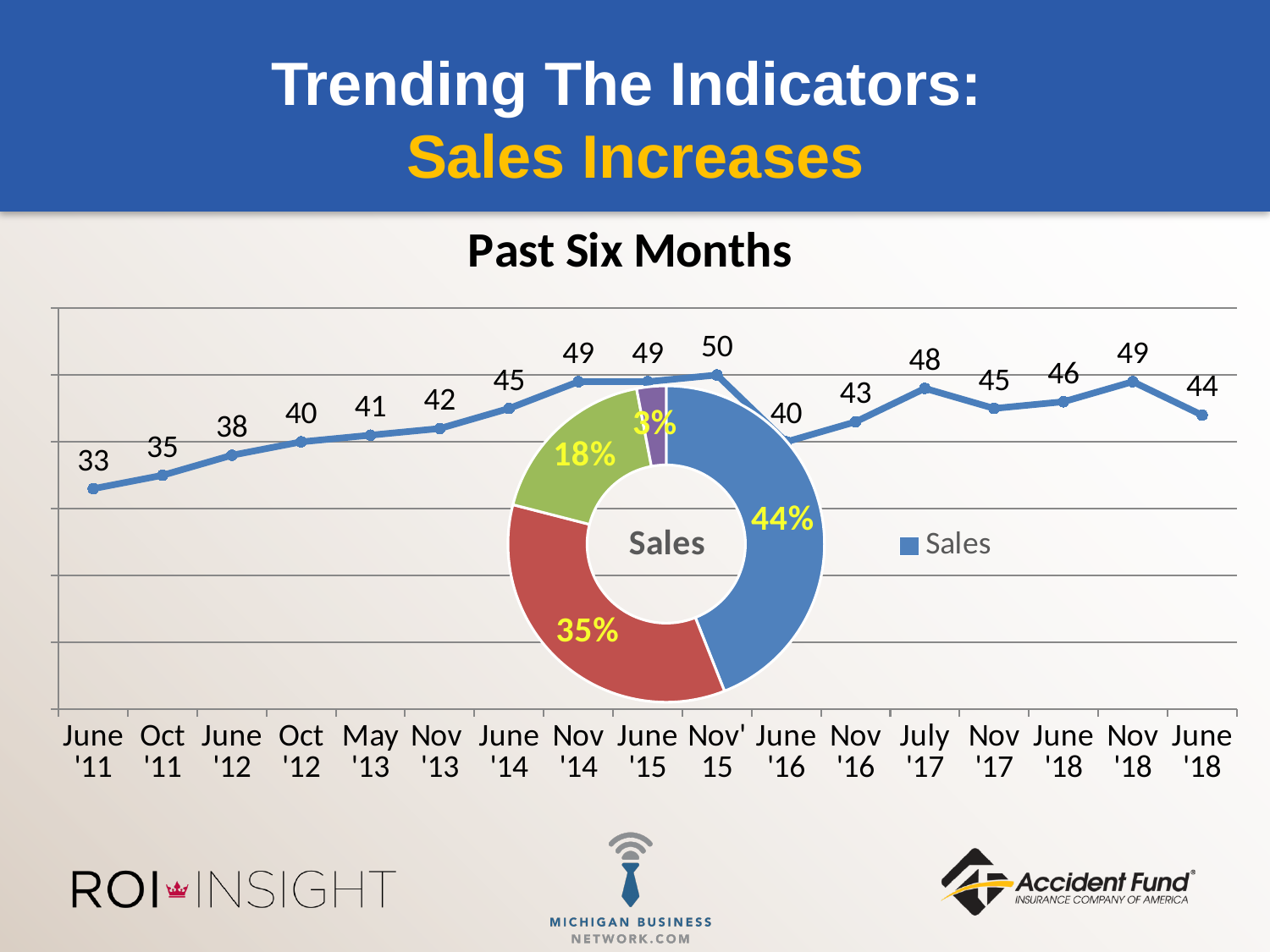
On the line chart, which is larger, the value for Oct '12 or the value for Nov '16? Nov '16 On the line chart, how many data points are plotted? 17 On the line chart, which period has the lowest value? June '11 On the doughnut chart, what share does the largest slice represent? 44% On the line chart, what is the value for June '16? 40 On the line chart, what is the value for Nov '14? 49 On the line chart, do the values rise or fall from June '11 to Nov' 15? rise On the line chart, what is the value for July '17? 48 On the line chart, which period has the highest value? Nov' 15 On the line chart, what is the difference between the values for Nov' 15 and June '16? 10 What kind of chart is the chart labelled 'Sales' in the centre? doughnut chart On the doughnut chart, how many slices are there? 4